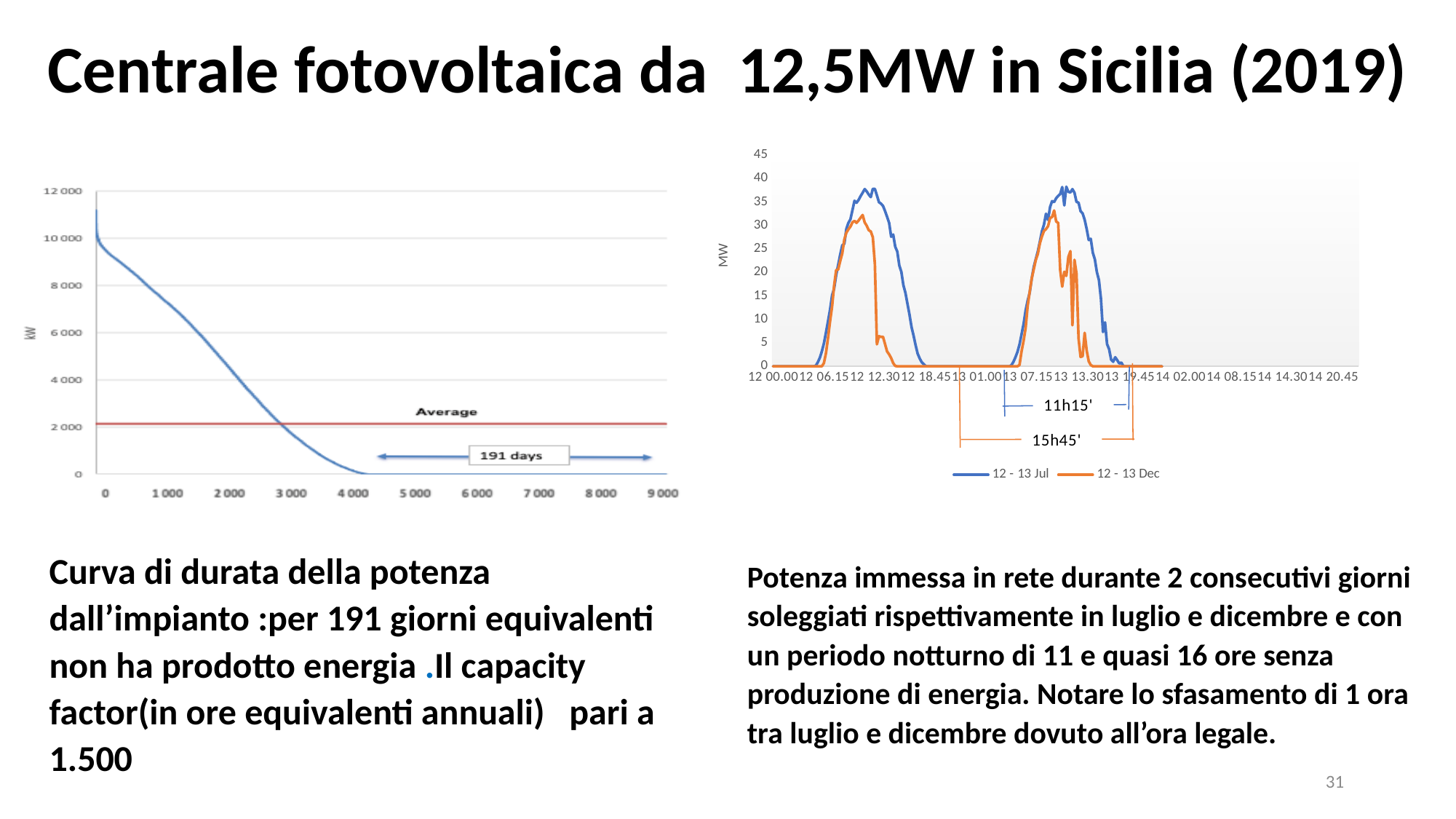
In the right-hand chart, is the peak value of the 12 - 13 Jul series greater or less than 35? greater In the left-hand chart, does the curve rise or fall as you move along the x axis? fall In the right-hand chart, is the peak value of the 12 - 13 Dec series greater or less than 35? less What duration is marked by the shorter annotated arrow below the right-hand chart? 11h15' What are the two series named in the legend of the right-hand chart? 12 - 13 Jul and 12 - 13 Dec What kind of chart is the chart on the right of the slide? line chart In the right-hand chart, is the peak value of the 12 - 13 Dec series greater or less than 30? greater What is the unit shown on the y axis of the right-hand chart? MW In the right-hand chart, which series reaches the higher peak, 12 - 13 Jul or 12 - 13 Dec? 12 - 13 Jul What kind of chart is the chart on the left of the slide? line chart How many series does the legend of the right-hand chart list? 2 What duration is marked by the longer annotated arrow below the right-hand chart? 15h45'